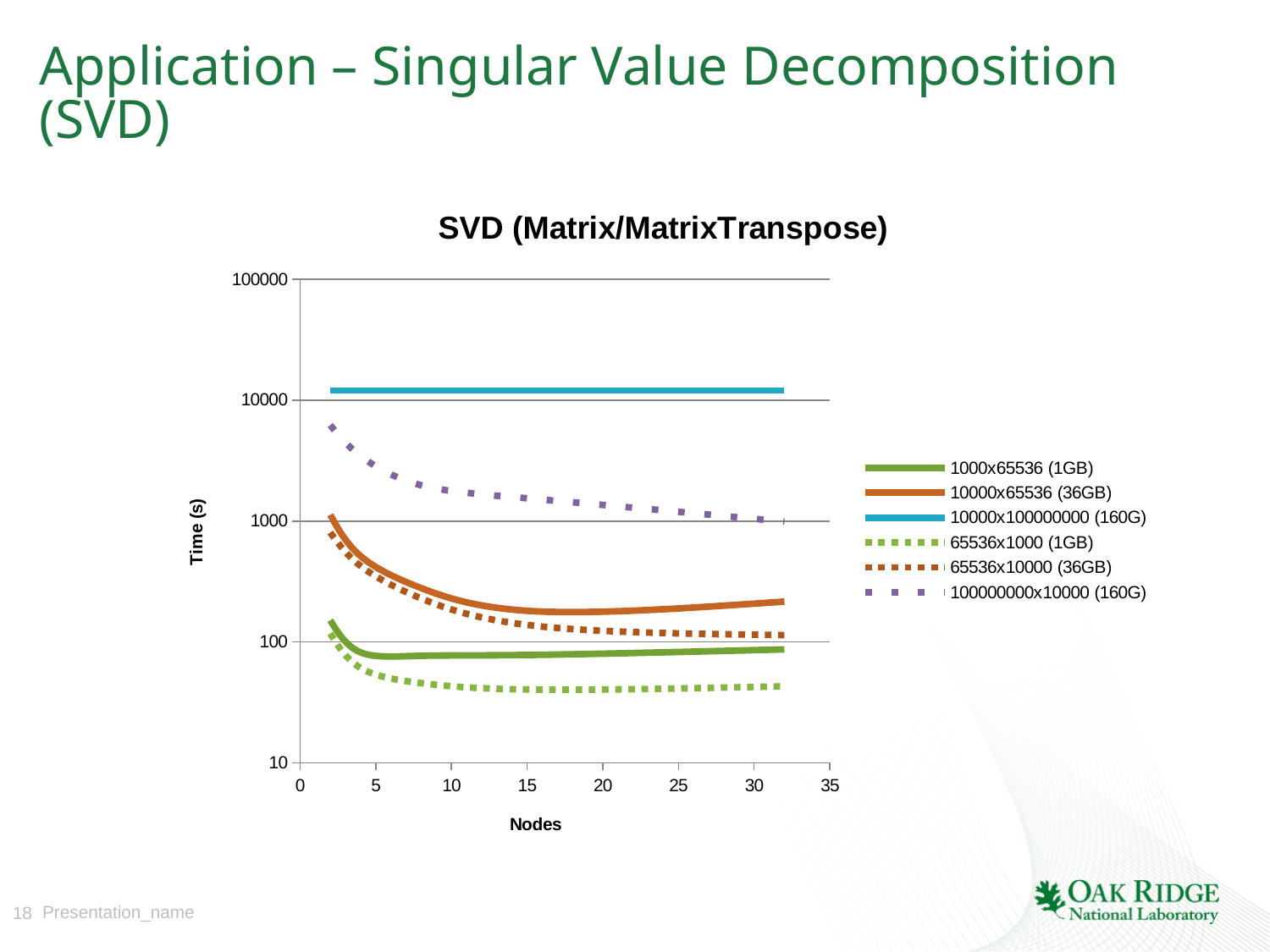
Does the time for the 100000000x10000 (160G) series rise or fall as the number of nodes increases? fall What is the label of the y axis? Time (s) At 30 nodes, which series has the higher time: 10000x65536 (36GB) or 65536x10000 (36GB)? 10000x65536 (36GB) What is the title of the chart? SVD (Matrix/MatrixTranspose) Which series has the lowest time at 30 nodes? 65536x1000 (1GB) How many series does the legend list? 6 Is the value for the 65536x1000 (1GB) series at 30 nodes greater or less than 100? less Is the value for the 10000x100000000 (160G) series greater or less than 10000? greater Which series has the highest time across the chart? 10000x100000000 (160G) What kind of chart is shown on the slide? line chart Is the value for the 100000000x10000 (160G) series at 5 nodes greater or less than 1000? greater